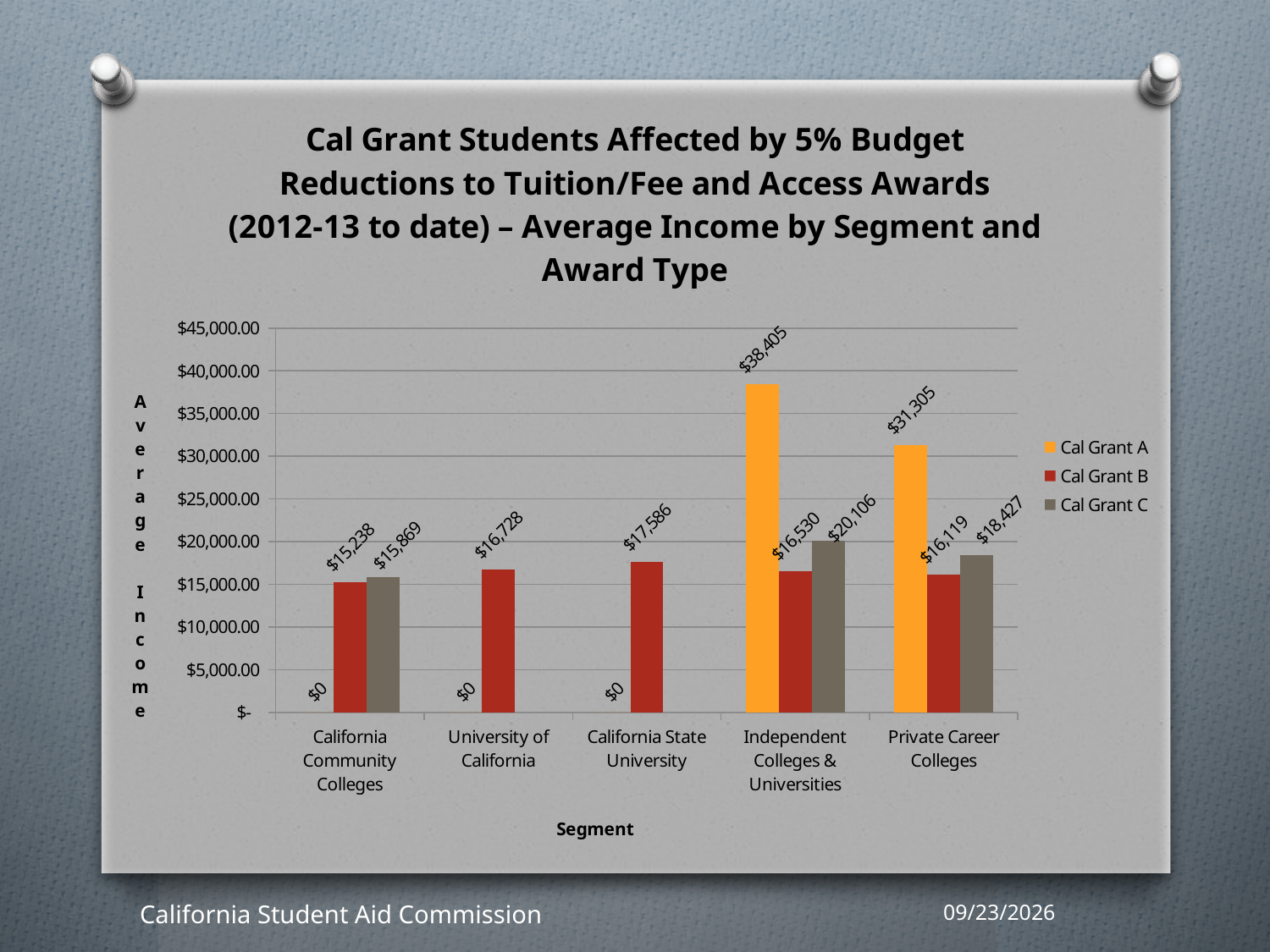
What is the difference between the Cal Grant A values for Independent Colleges & Universities and Private Career Colleges? $7,100 What is the Cal Grant A value for Independent Colleges & Universities? $38,405 Which is larger for Independent Colleges & Universities: the Cal Grant B value or the Cal Grant C value? Cal Grant C How many series does the legend list? 3 What is the Cal Grant A value for University of California? $0 Which segment has the lowest Cal Grant B value? California Community Colleges What kind of chart is shown on the slide? bar chart How many segments are shown on the x axis? 5 What is the Cal Grant B value for California State University? $17,586 Is the Cal Grant A value for Private Career Colleges greater or less than $30,000.00? greater Which segment has the highest Cal Grant B value? California State University What is the Cal Grant C value for Private Career Colleges? $18,427